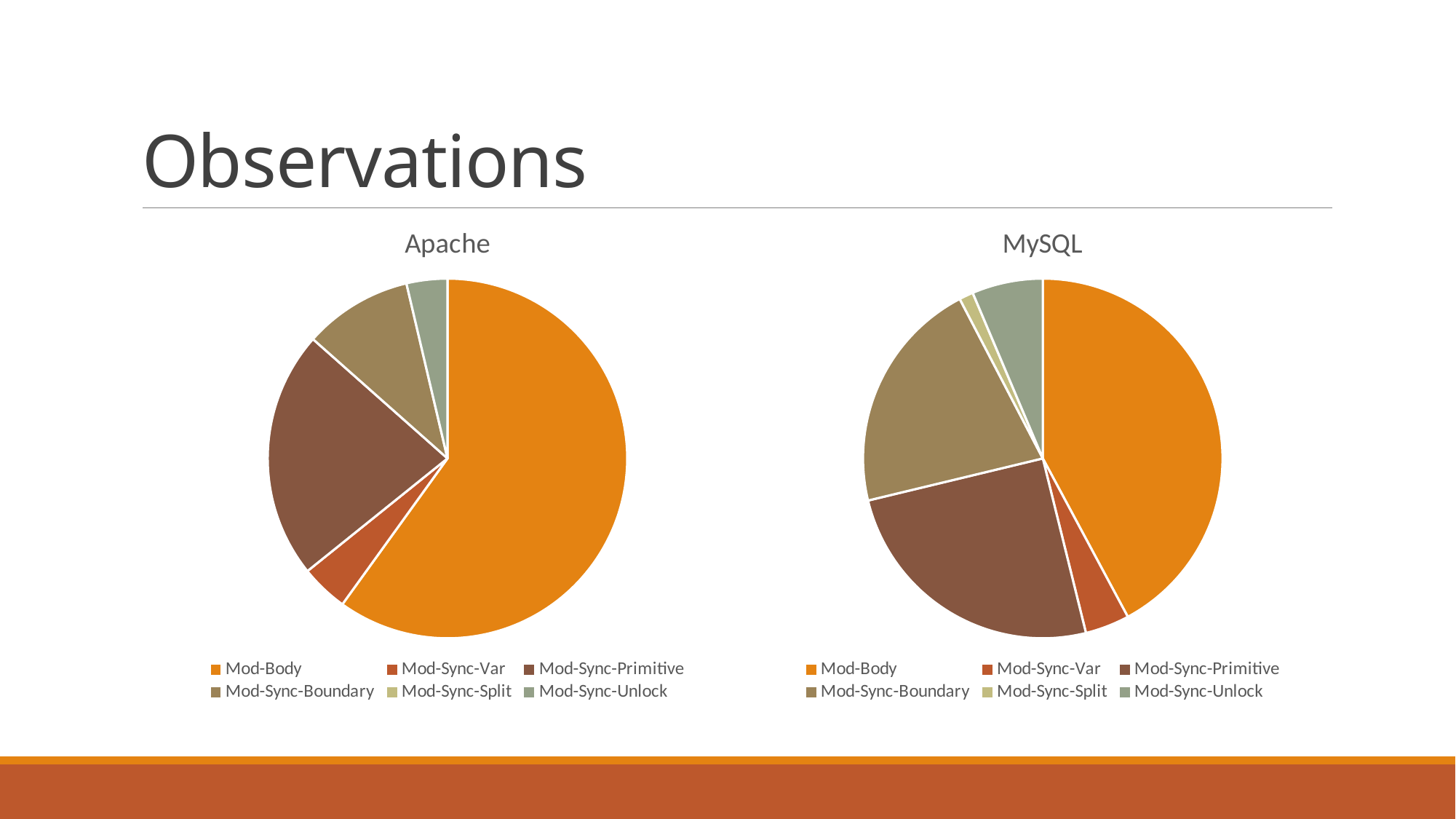
In the MySQL chart, which slice is larger: Mod-Sync-Boundary or Mod-Sync-Unlock? Mod-Sync-Boundary What kind of chart is the MySQL chart? pie chart In the MySQL chart, which category has the smallest slice? Mod-Sync-Split In the Apache chart, which category has the largest slice? Mod-Body What kind of chart is the Apache chart? pie chart How many pie charts are shown on the slide? 2 In the MySQL chart, which category has the largest slice? Mod-Body How many categories does the legend of the MySQL chart list? 6 In the MySQL chart, which slice is larger: Mod-Sync-Primitive or Mod-Sync-Boundary? Mod-Sync-Primitive What colour represents Mod-Body in the Apache chart? orange In the Apache chart, which slice is larger: Mod-Sync-Primitive or Mod-Sync-Boundary? Mod-Sync-Primitive